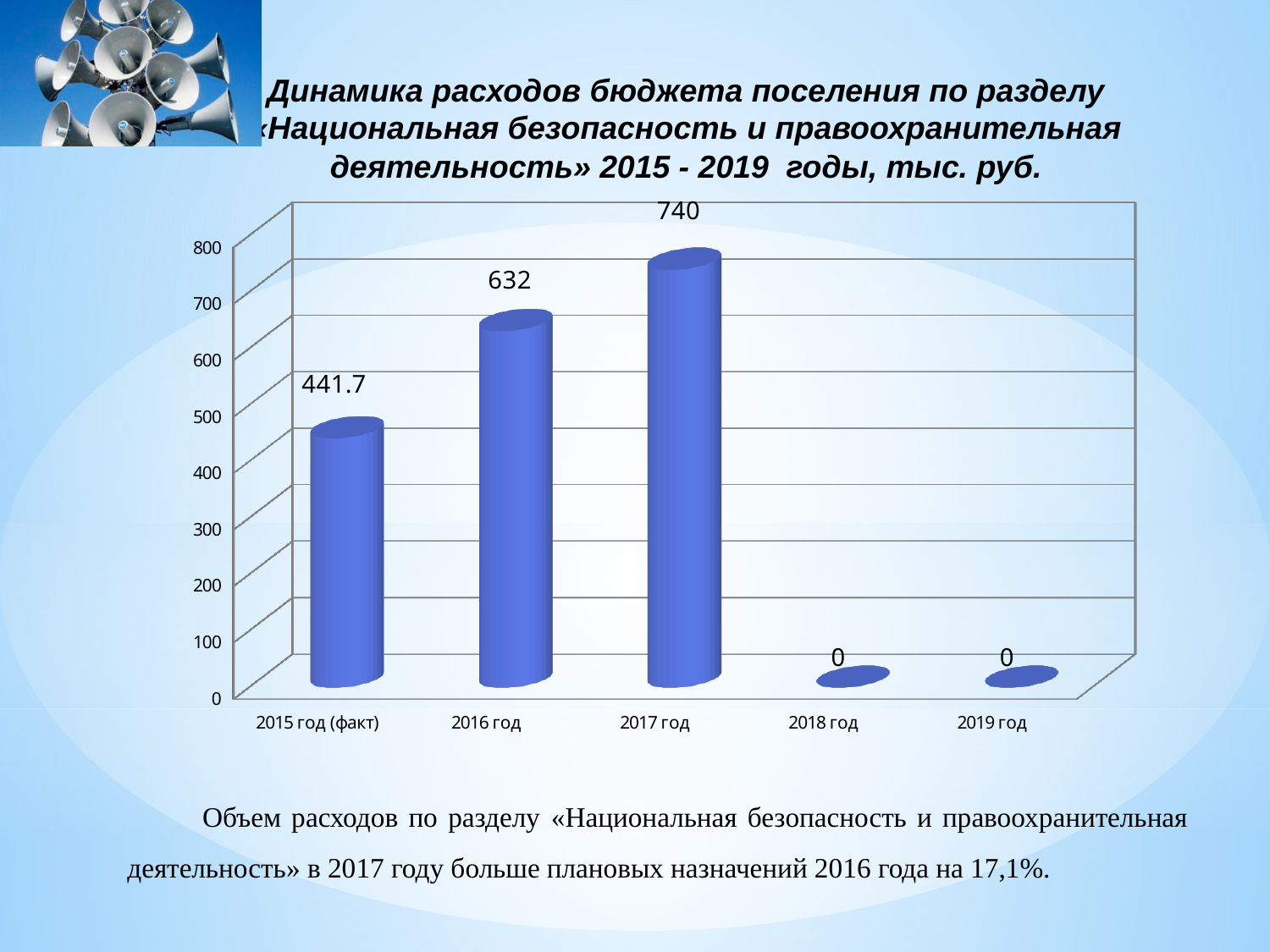
How many categories are shown on the x axis? 5 Which is larger, the value for 2016 год or the value for 2015 год (факт)? 2016 год Do the values rise or fall from 2015 год (факт) to 2017 год? rise What is the value for 2015 год (факт)? 441.7 What is the difference between the values for 2017 год and 2016 год? 108 Which year has the highest value? 2017 год Is the value for 2017 год greater or less than 700? greater What is the value for 2017 год? 740 What is the value for 2018 год? 0 What kind of chart is shown on the slide? bar chart What is the difference between the values for 2016 год and 2015 год (факт)? 190.3 What is the value for 2016 год? 632